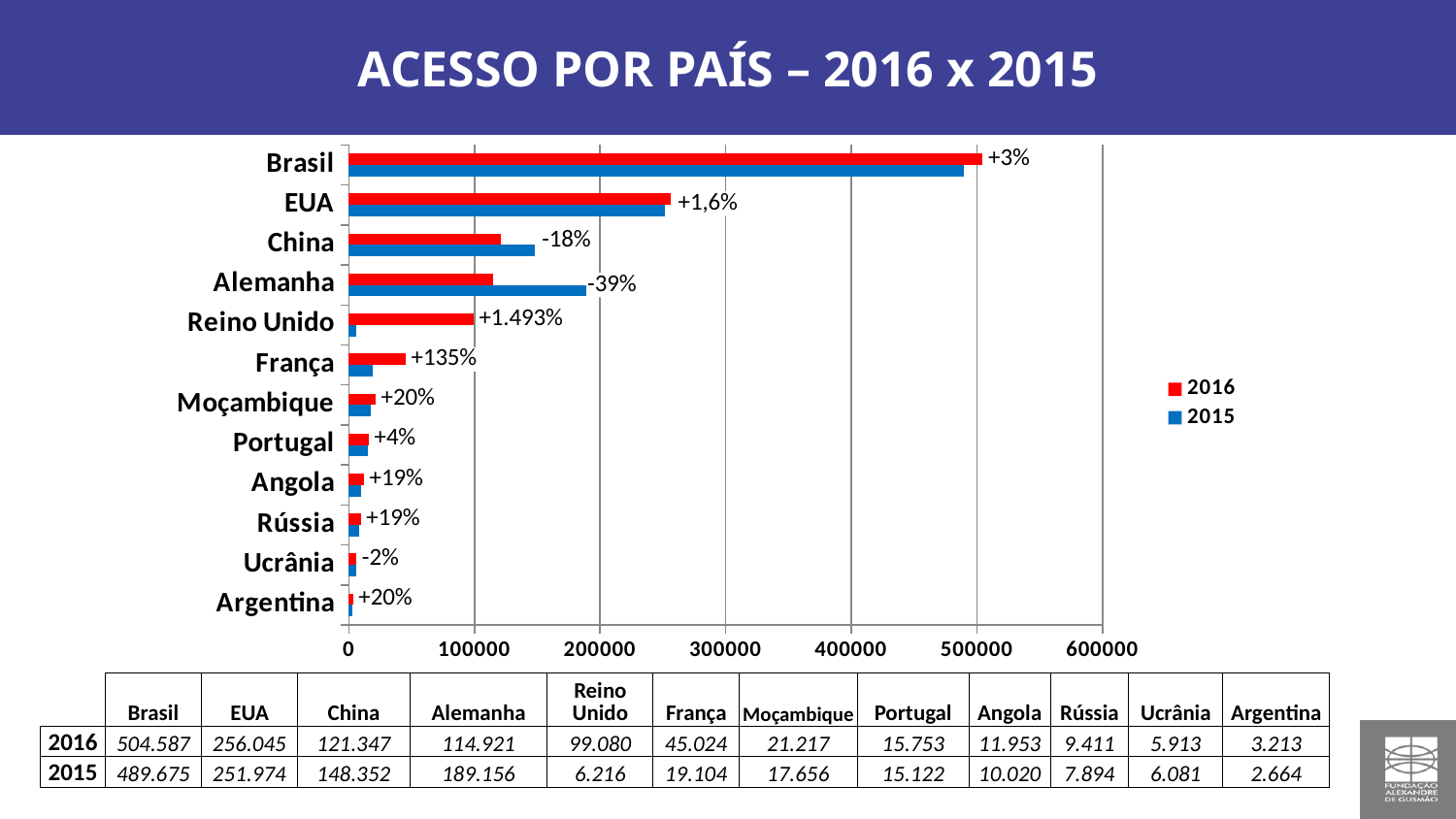
What is the difference between the 2016 and 2015 values for Brasil? 14.912 What is the 2015 value for Alemanha? 189.156 What type of chart is shown on the slide? bar chart How many countries are shown in the chart? 12 How many series does the legend list? 2 Which country has the lowest 2015 value? Argentina Which is larger for China: the 2016 value or the 2015 value? 2015 What is the 2016 value for Brasil? 504.587 Is the 2016 value for EUA greater or less than 200000? greater What percentage change label is shown next to the Reino Unido bars? +1.493% Which country has the highest 2016 value? Brasil What is the 2016 value for Reino Unido? 99.080